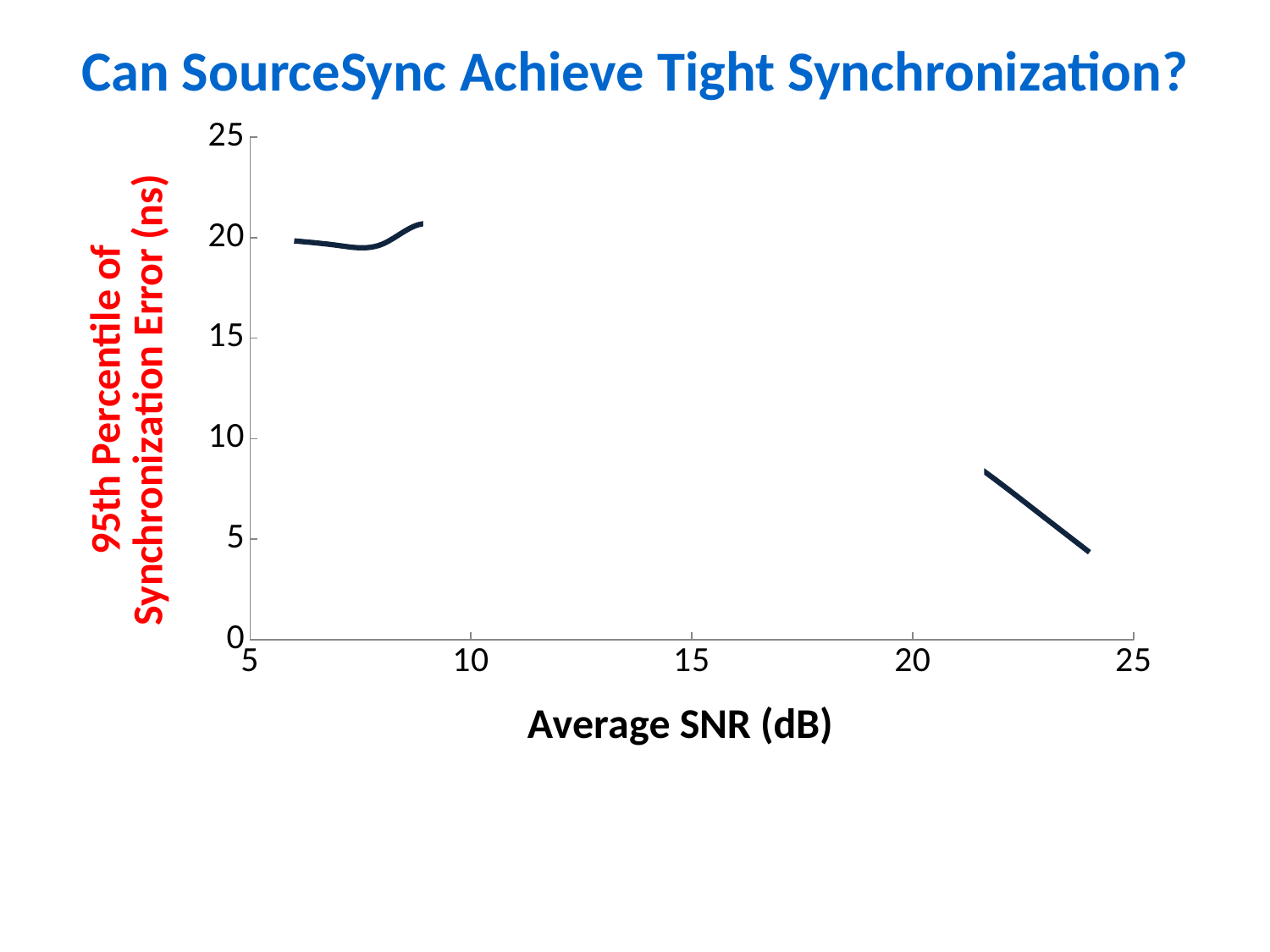
Is the synchronization error at an average SNR of about 6 dB greater or less than 15 ns? greater Is the synchronization error at an average SNR of about 24 dB greater or less than 10 ns? less What is the maximum value shown on the y axis? 25 Is the synchronization error at an average SNR of about 9 dB greater or less than 25 ns? less Within the right-hand segment (SNR from about 22 to 24 dB), does the synchronization error rise or fall as SNR increases? fall What is the title of the chart on the slide? Can SourceSync Achieve Tight Synchronization? Which has the larger synchronization error: an average SNR of about 6 dB or about 24 dB? about 6 dB Overall, does the synchronization error rise or fall as the average SNR increases from the left segment to the right segment? fall What kind of chart is shown on the slide? line chart What is the label of the x axis? Average SNR (dB)